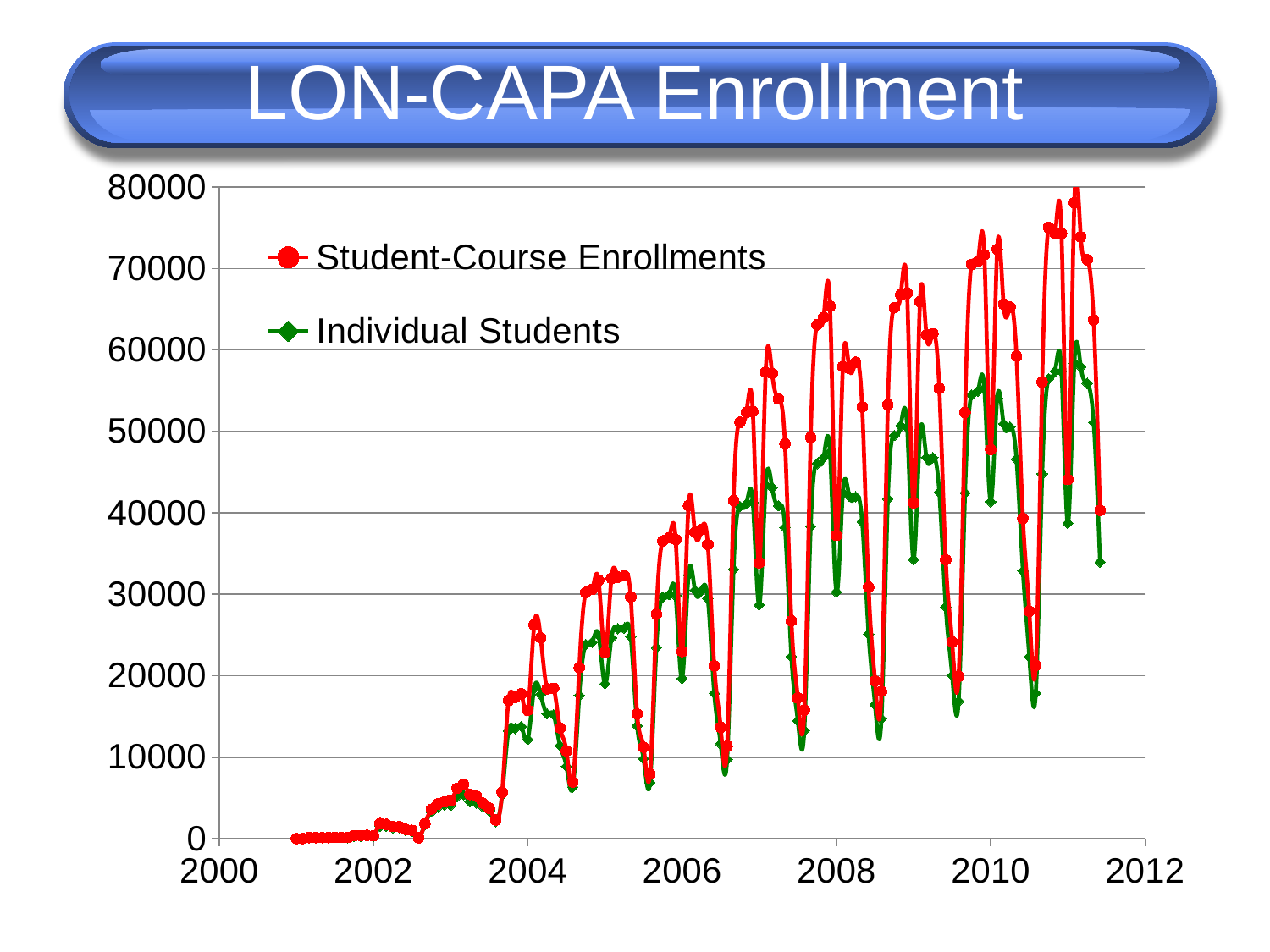
How many series does the legend list? 2 Overall, do the Individual Students values rise or fall from 2001 to 2011? rise Are the Student-Course Enrollments values in 2001 greater or less than 10000? less Is the highest value of Student-Course Enrollments greater or less than 70000? greater What kind of chart is shown on the slide? line chart Is the highest value of Individual Students greater or less than 70000? less Which series reaches higher values, Student-Course Enrollments or Individual Students? Student-Course Enrollments What is the highest value shown on the vertical axis? 80000 Overall, do the Student-Course Enrollments values rise or fall from 2001 to 2011? rise Which series is drawn in red? Student-Course Enrollments What is the title of the chart? LON-CAPA Enrollment